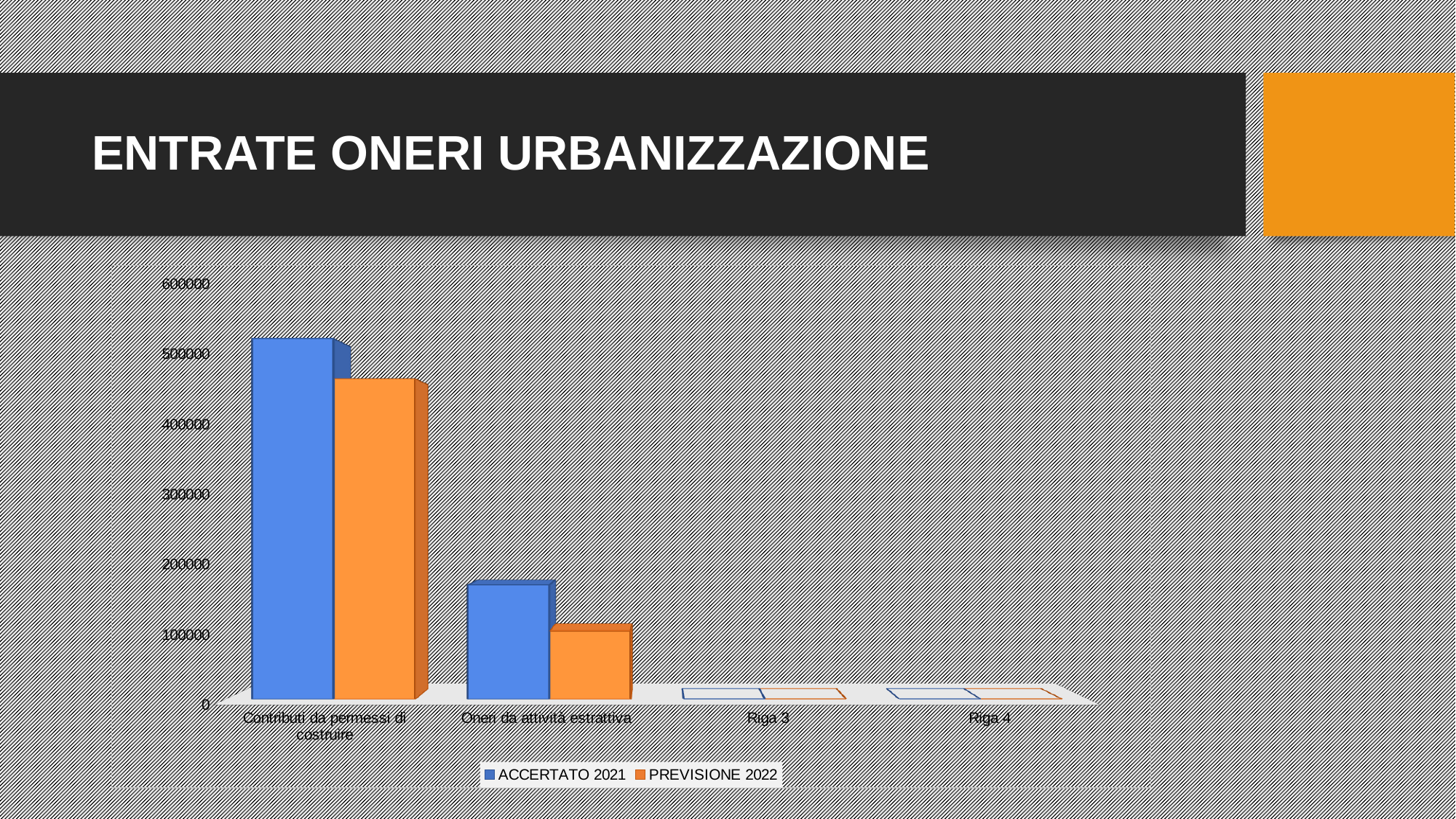
What kind of chart is shown on the slide? bar chart How many series does the legend list? 2 Which category has the highest value for ACCERTATO 2021? Contributi da permessi di costruire Is the ACCERTATO 2021 value for Contributi da permessi di costruire greater or less than 400000? greater What is the title of the slide? ENTRATE ONERI URBANIZZAZIONE For Oneri da attività estrattiva, which is larger: ACCERTATO 2021 or PREVISIONE 2022? ACCERTATO 2021 Which category has the highest value for PREVISIONE 2022? Contributi da permessi di costruire Which series is shown in orange? PREVISIONE 2022 For Contributi da permessi di costruire, which is larger: ACCERTATO 2021 or PREVISIONE 2022? ACCERTATO 2021 Is the PREVISIONE 2022 value for Contributi da permessi di costruire greater or less than 500000? less How many categories are shown on the x axis? 4 Is the ACCERTATO 2021 value for Oneri da attività estrattiva greater or less than 200000? less